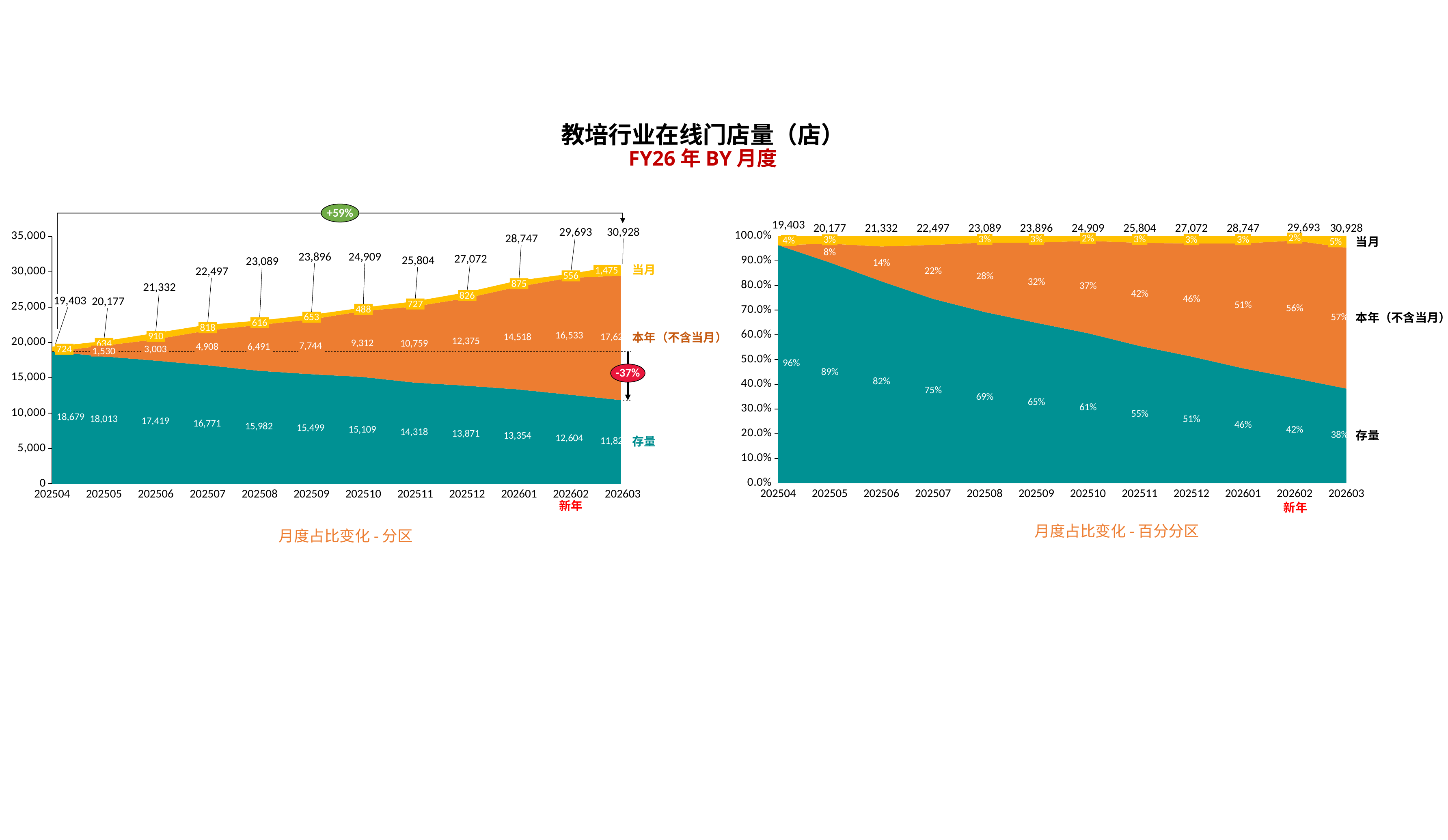
In the right chart (月度占比变化 - 百分分区), which is larger for 202510: the 存量 share or the 本年（不含当月） share? 存量 What percentage growth is shown in the green callout above the left chart? +59% In the left chart (月度占比变化 - 分区), what is the total number of stores for 202603? 30,928 In the left chart (月度占比变化 - 分区), does the 存量 series rise or fall from 202504 to 202603? fall In the left chart (月度占比变化 - 分区), what is the 存量 value for 202504? 18,679 In the left chart (月度占比变化 - 分区), how many months are shown on the x axis? 12 In the left chart (月度占比变化 - 分区), what is the 当月 value for 202603? 1,475 In the right chart (月度占比变化 - 百分分区), what is the 本年（不含当月） share for 202601? 51% In the left chart (月度占比变化 - 分区), what is the difference between the total for 202603 and the total for 202504? 11,525 In the left chart (月度占比变化 - 分区), what is the 本年（不含当月） value for 202512? 12,375 In the left chart (月度占比变化 - 分区), which month has the highest total number of stores? 202603 In the right chart (月度占比变化 - 百分分区), what is the 存量 share for 202603? 38%